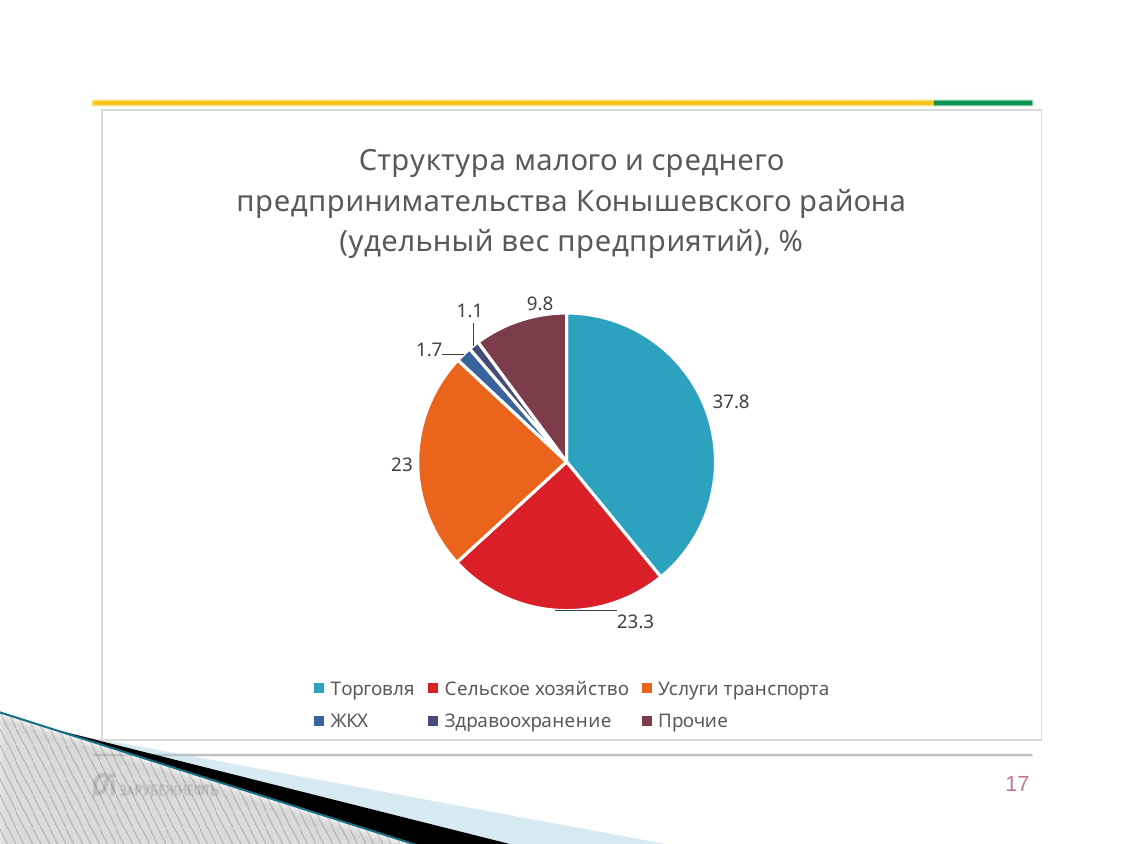
Which category has the largest slice of the pie? Торговля What is the value for Прочие? 9.8 What colour is the slice for Услуги транспорта? Orange Which category has the smallest slice of the pie? Здравоохранение What type of chart is shown on the slide? Pie chart How many categories does the legend list? 6 What is the difference between the values for Торговля and Сельское хозяйство? 14.5 What is the value for Услуги транспорта? 23 What is the value for Торговля? 37.8 Which is larger, the value for Прочие or the value for ЖКХ? Прочие What is the value for Здравоохранение? 1.1 What is the value for Сельское хозяйство? 23.3